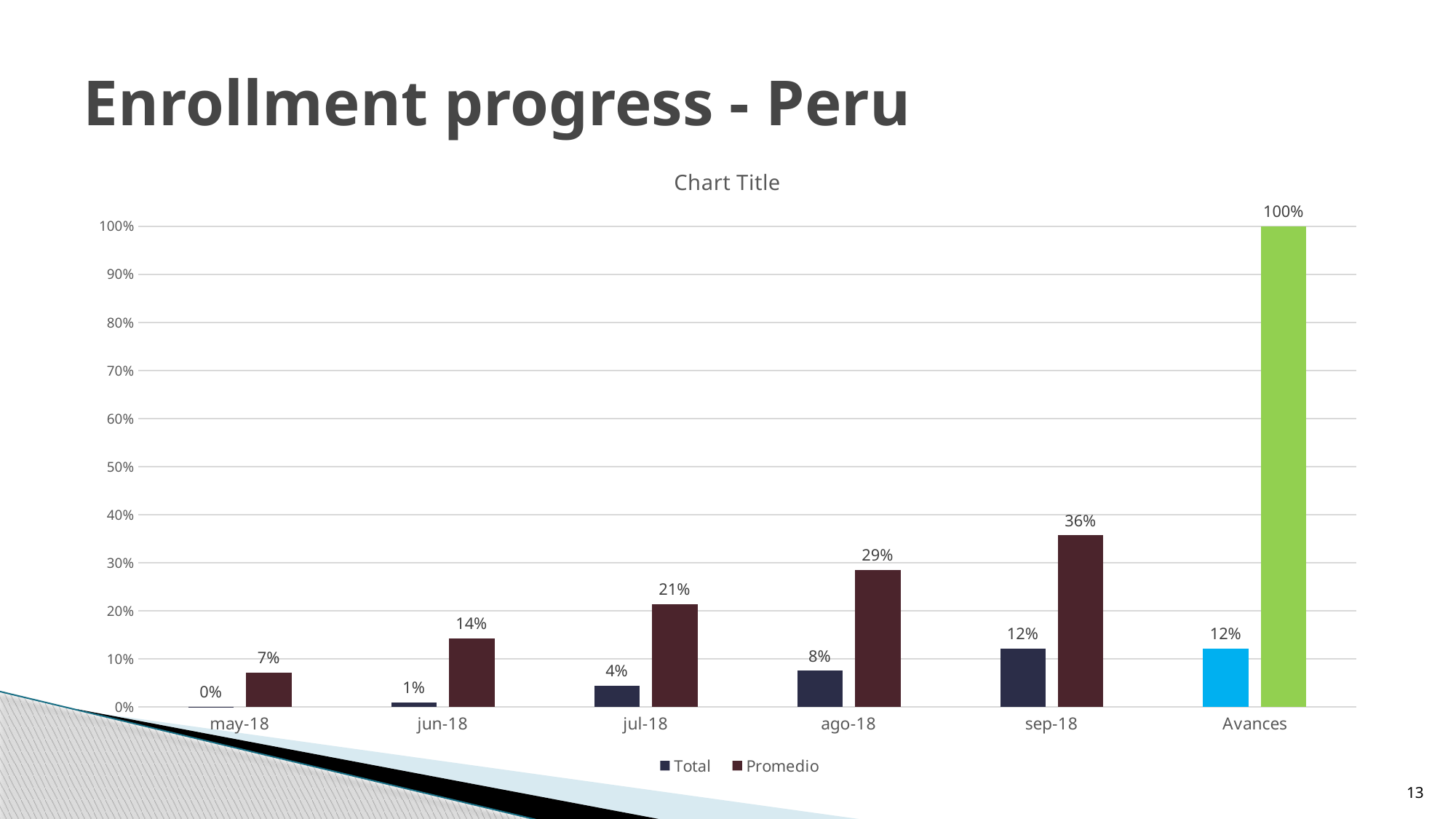
Which month has the lowest Total value? may-18 What kind of chart is shown on the slide? Bar chart Which is larger, the Total value for jul-18 or the Promedio value for jun-18? Promedio value for jun-18 How many series does the legend list? 2 How many categories are shown on the x axis? 6 What is the difference between the Promedio value for sep-18 and the Promedio value for ago-18? 7% What is the Total value for jun-18? 1% Which category has the highest Promedio value among the months? sep-18 What is the Total value for ago-18? 8% What is the Promedio value for sep-18? 36% Do the Promedio values rise or fall from may-18 to sep-18? Rise What is the Promedio value for jul-18? 21%